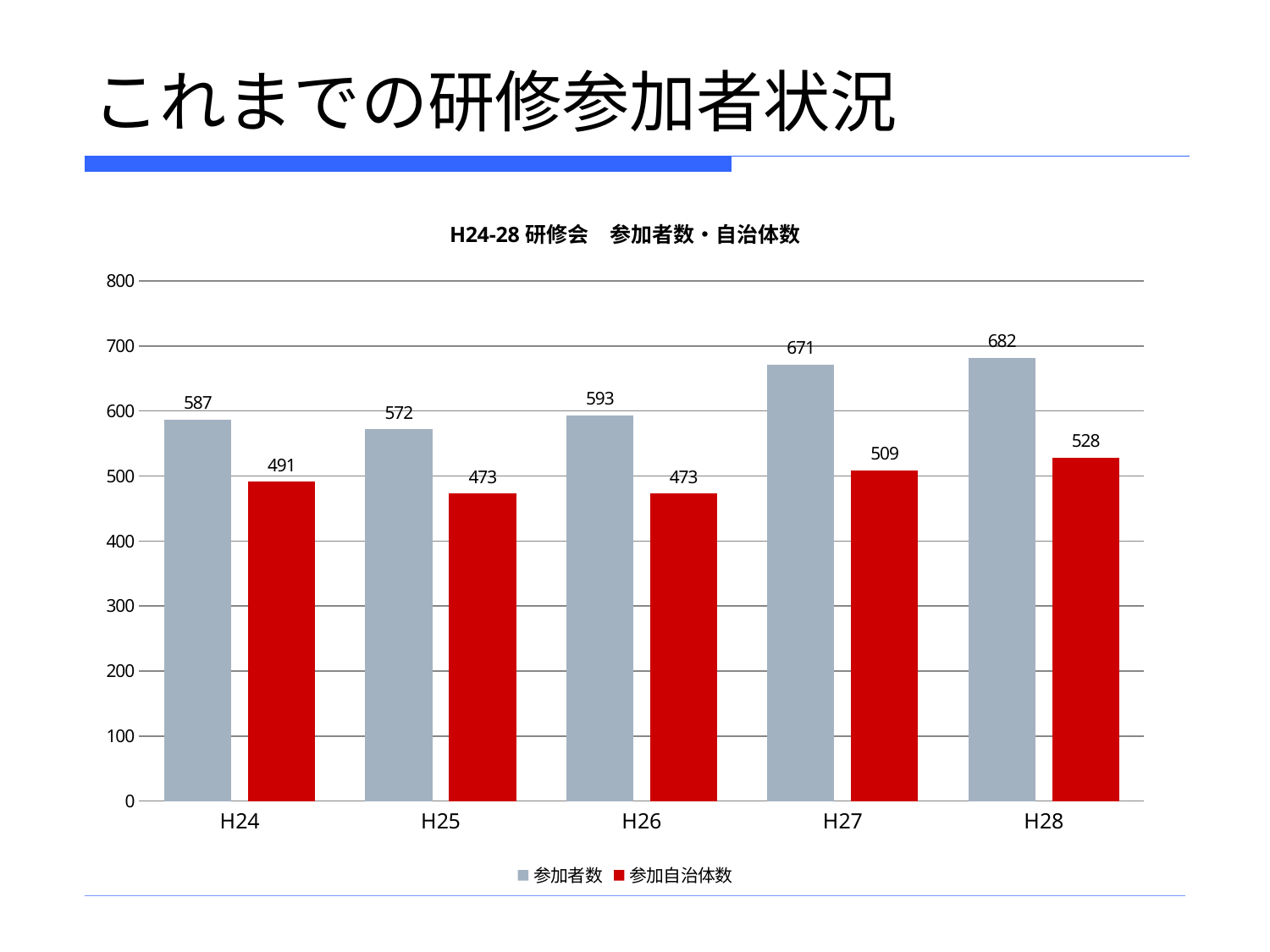
Which year has the highest 参加者数? H28 How many series does the legend list? 2 What is the 参加自治体数 value for H27? 509 What is the 参加者数 value for H24? 587 What is the title of the chart? H24-28 研修会 参加者数・自治体数 How many years are shown on the x axis? 5 Which year has the lowest 参加者数? H25 What kind of chart is shown on the slide? Bar chart What is the difference in 参加者数 between H27 and H26? 78 What is the difference between the 参加者数 and 参加自治体数 values for H28? 154 Which is larger, the 参加自治体数 for H24 or for H25? H24 Is the 参加者数 value for H27 greater or less than 600? greater